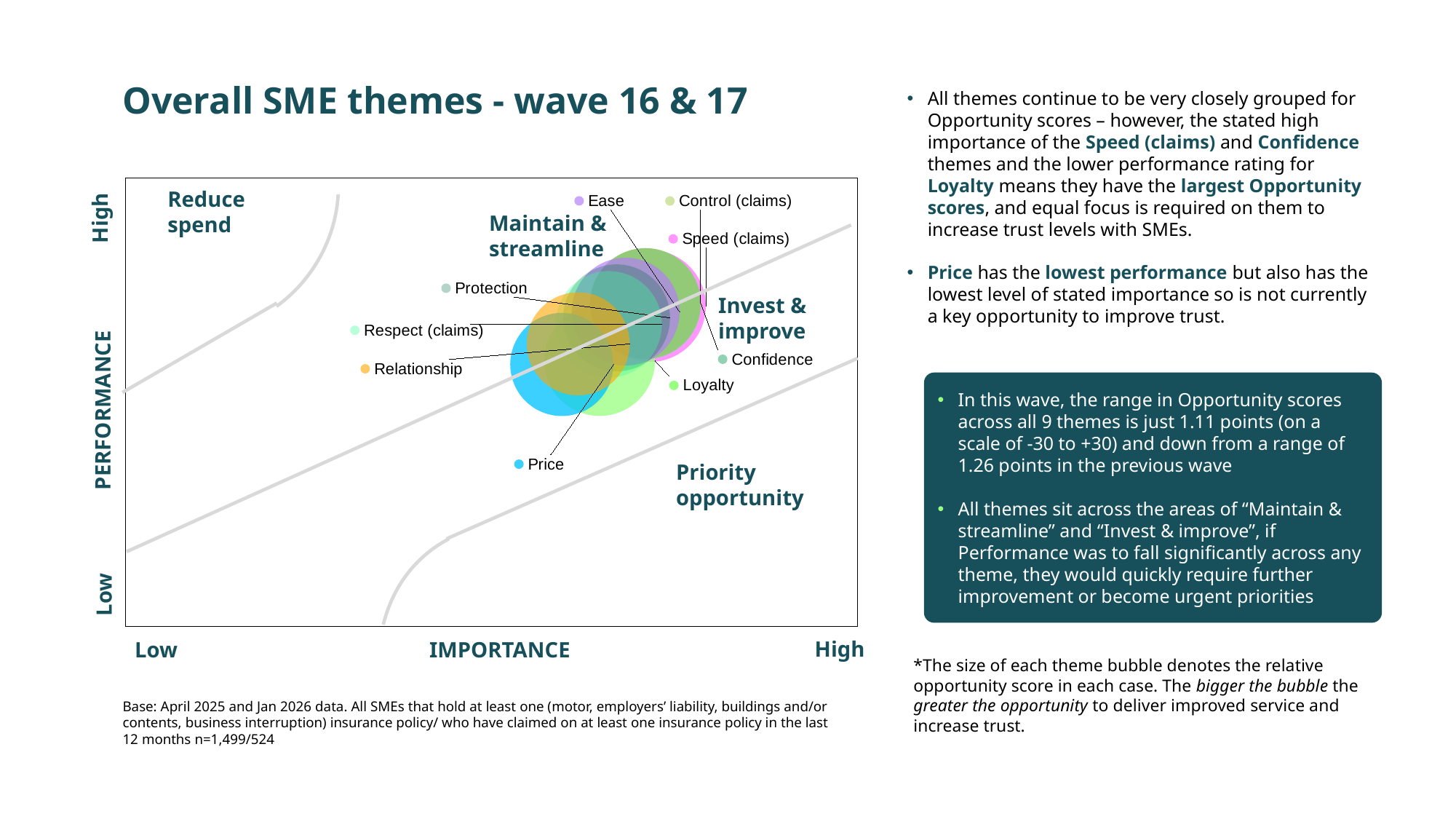
Is the performance for Price higher or lower than the performance for Loyalty? Lower Is the importance for Speed (claims) higher or lower than the importance for Price? Higher What is the label of the horizontal axis of the chart? IMPORTANCE How many themes are plotted on the chart? 9 Is the performance for Ease higher or lower than the performance for Price? Higher Which theme has the lowest importance on the chart? Price What kind of chart is shown on the slide? Bubble chart What is the title of the slide's chart? Overall SME themes - wave 16 & 17 Which theme has the lowest performance on the chart? Price